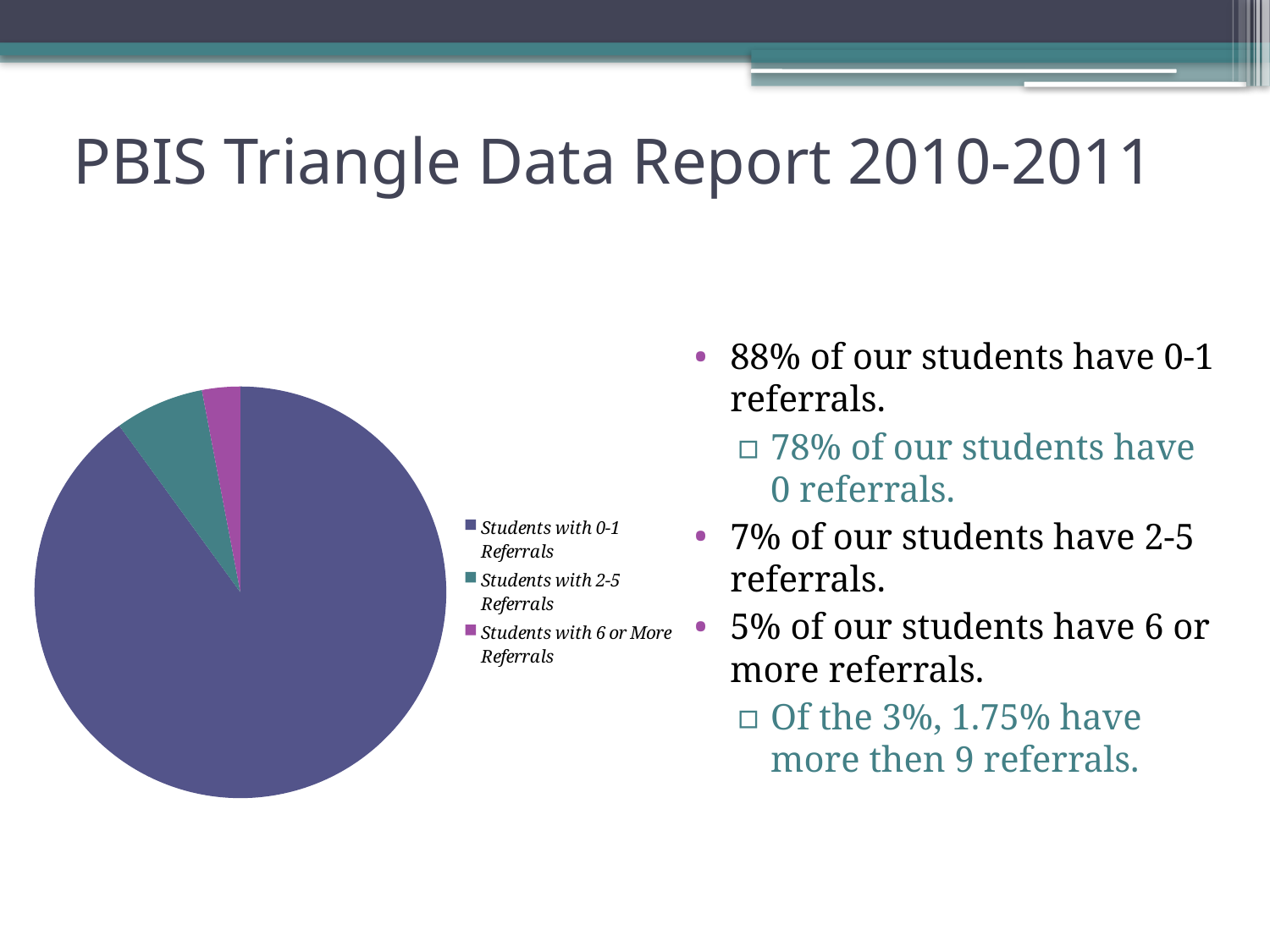
Does the slice for Students with 0-1 Referrals take up more or less than half of the pie? More What kind of chart is shown on the slide? Pie chart Which category has the smallest slice in the pie chart? Students with 6 or More Referrals How many entries does the legend of the pie chart list? 3 What colour is the slice for Students with 6 or More Referrals? Magenta (pink-purple) Which slice is larger: Students with 2-5 Referrals or Students with 6 or More Referrals? Students with 2-5 Referrals How many slices does the pie chart have? 3 Which slice is larger: Students with 0-1 Referrals or Students with 2-5 Referrals? Students with 0-1 Referrals What colour is the slice for Students with 0-1 Referrals? Purple (dark blue-purple) Which category has the largest slice in the pie chart? Students with 0-1 Referrals